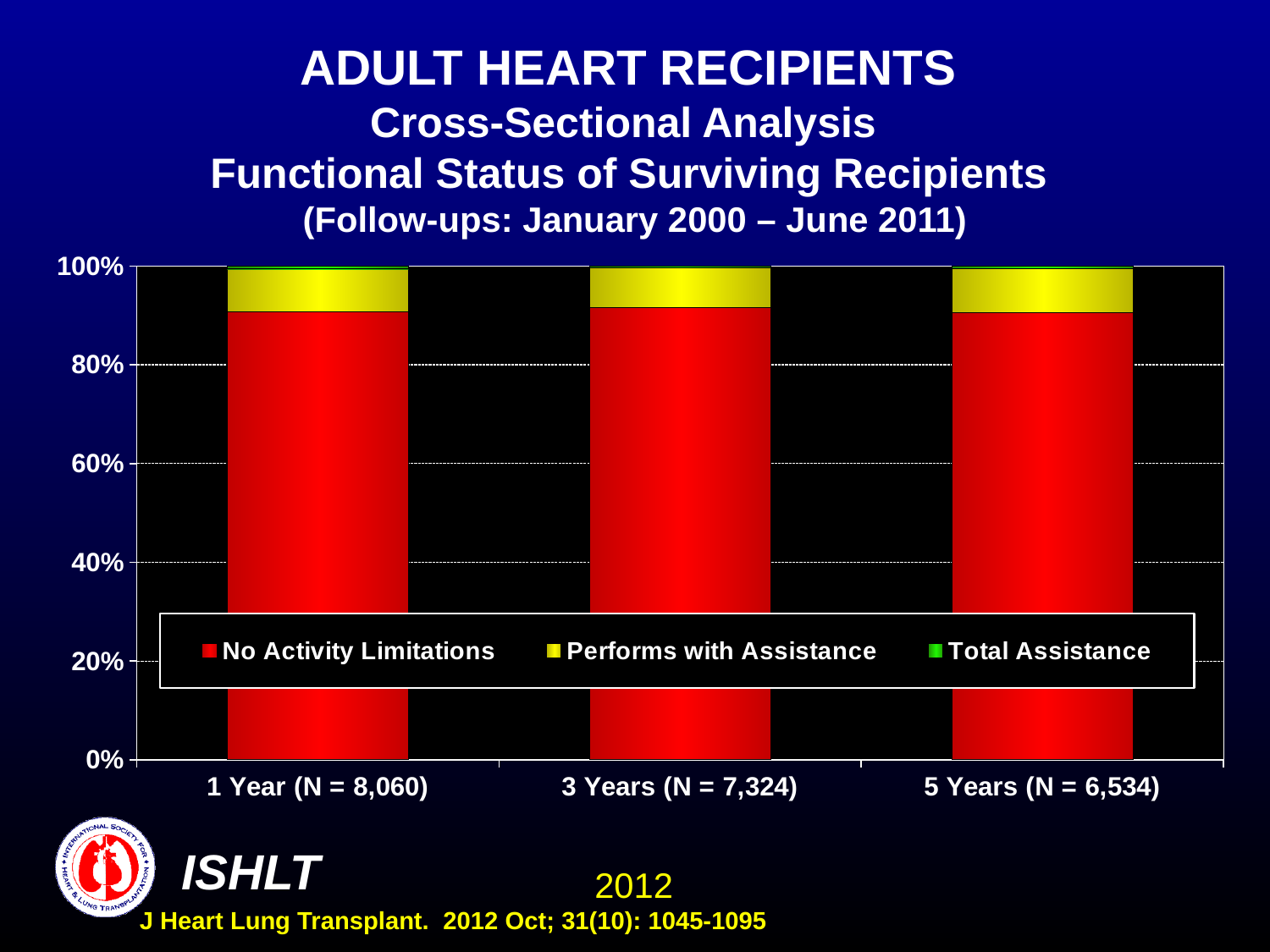
Is the value for No Activity Limitations at 5 Years greater or less than 60%? greater How many categories are shown on the x axis of the chart? 3 At 5 Years, which is larger: Performs with Assistance or Total Assistance? Performs with Assistance Which series is shown in yellow in the legend? Performs with Assistance What is the N shown for the 3 Years category? 7,324 At 1 Year, which is larger: No Activity Limitations or Performs with Assistance? No Activity Limitations What kind of chart is shown on the slide? Stacked bar chart Is the value for No Activity Limitations at 1 Year greater or less than 80%? greater How many series does the legend list? 3 Is the value for Total Assistance at 1 Year greater or less than 20%? less